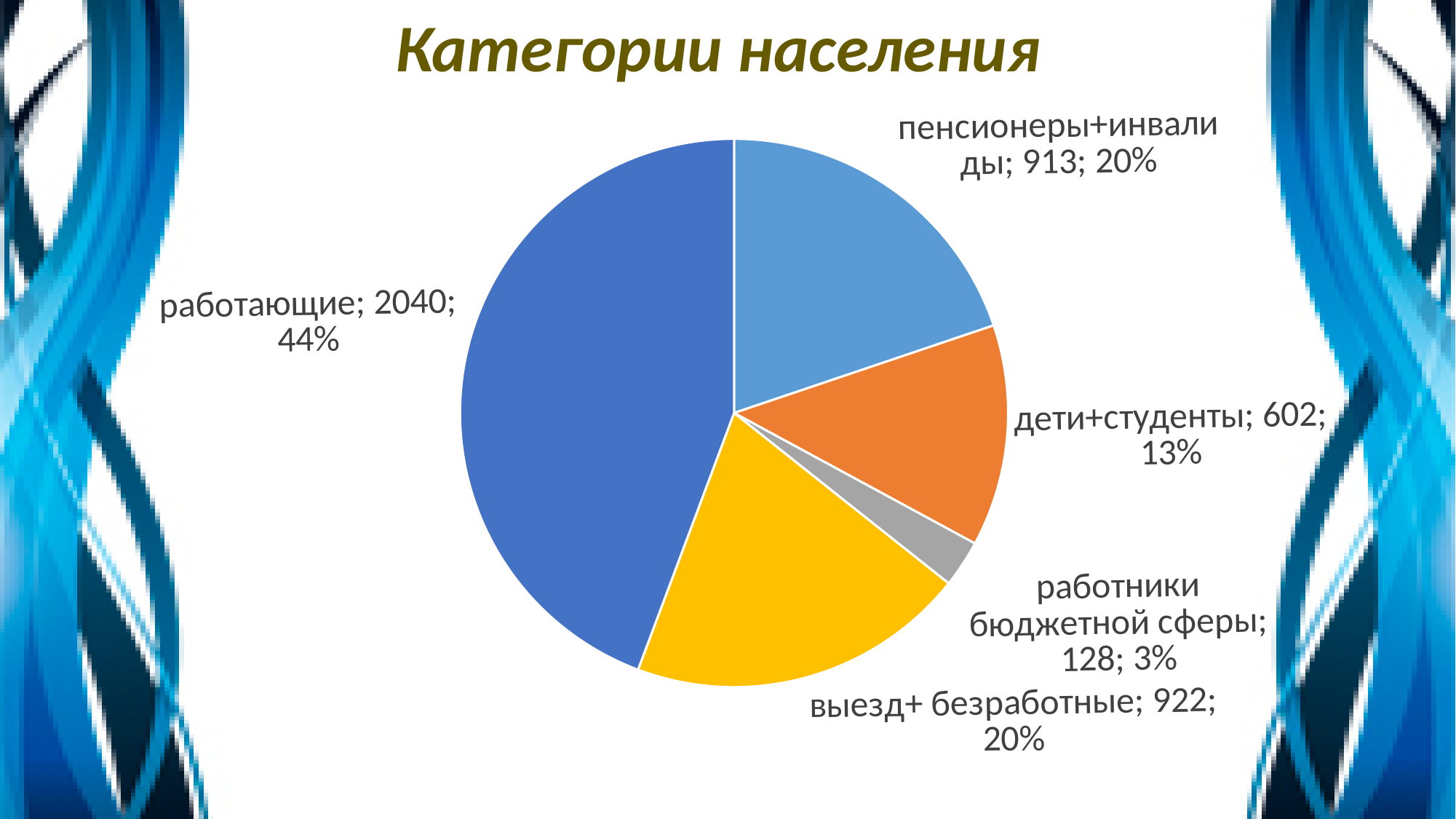
How many categories (slices) does the pie chart have? 5 Which category has the largest slice? работающие What is the title of the chart? Категории населения What is the difference between the values for работающие and дети+студенты? 1438 What is the value for дети+студенты? 602 What is the value for пенсионеры+инвалиды? 913 What is the value for работающие? 2040 What is the value for работники бюджетной сферы? 128 What share of the pie does выезд+ безработные represent? 20% Which category has the smallest slice? работники бюджетной сферы What kind of chart is shown on the slide? pie chart What share of the pie does работающие represent? 44%